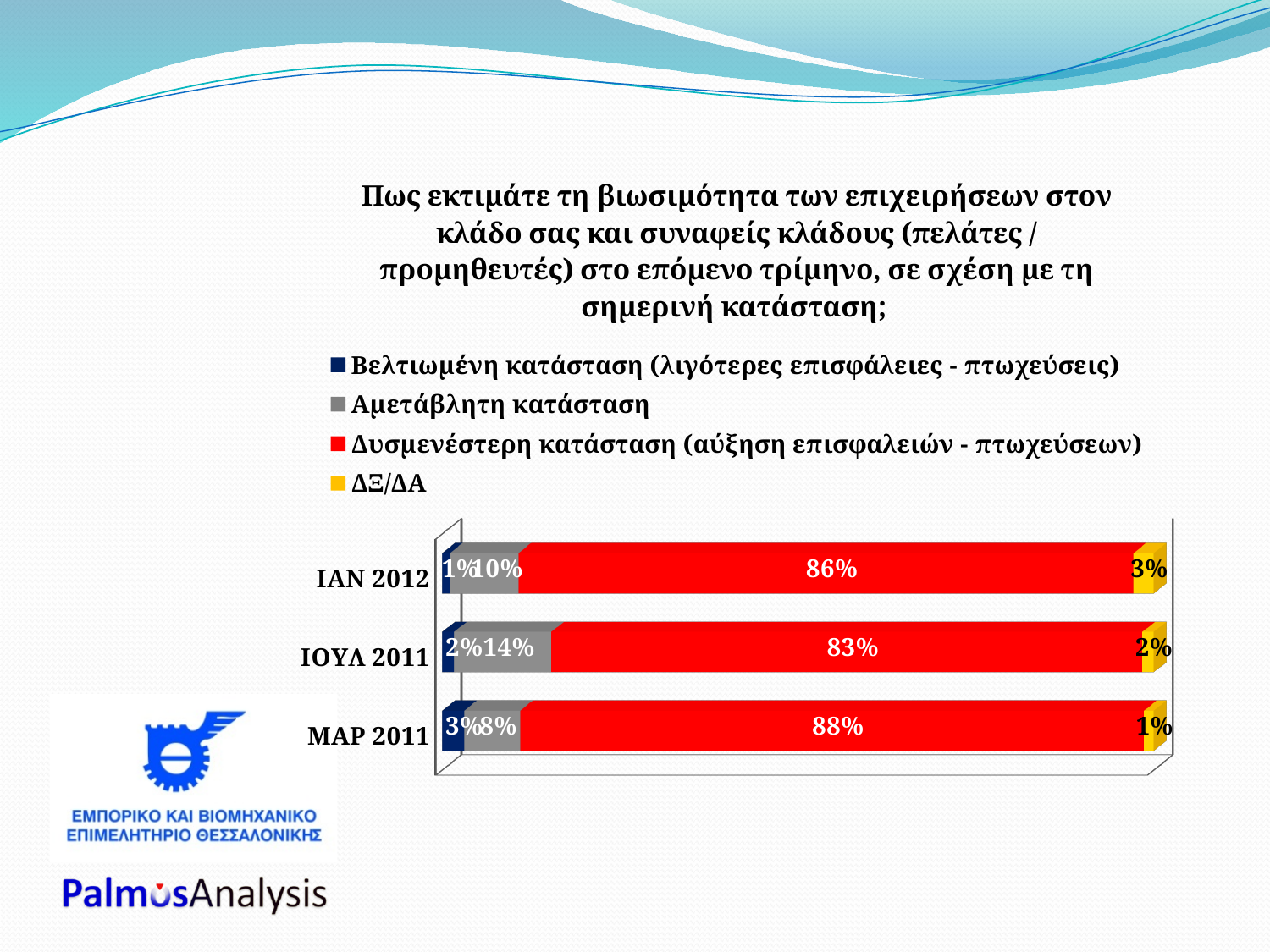
What kind of chart is shown on the slide? Stacked bar chart Which legend entry is shown in red? Δυσμενέστερη κατάσταση (αύξηση επισφαλειών - πτωχεύσεων) What is the difference between the Δυσμενέστερη κατάσταση values for ΜΑΡ 2011 and ΙΟΥΛ 2011? 5% In which period is the Δυσμενέστερη κατάσταση share highest? ΜΑΡ 2011 How many categories (time periods) are shown on the chart? 3 Which is larger: the Αμετάβλητη κατάσταση value for ΙΑΝ 2012 or for ΙΟΥΛ 2011? ΙΟΥΛ 2011 How many series does the legend list? 4 What is the value for Βελτιωμένη κατάσταση in ΜΑΡ 2011? 3% In which period is the Αμετάβλητη κατάσταση share lowest? ΜΑΡ 2011 What is the value for ΔΞ/ΔΑ in ΙΑΝ 2012? 3% What is the value for Δυσμενέστερη κατάσταση in ΙΑΝ 2012? 86% What is the value for Αμετάβλητη κατάσταση in ΙΟΥΛ 2011? 14%